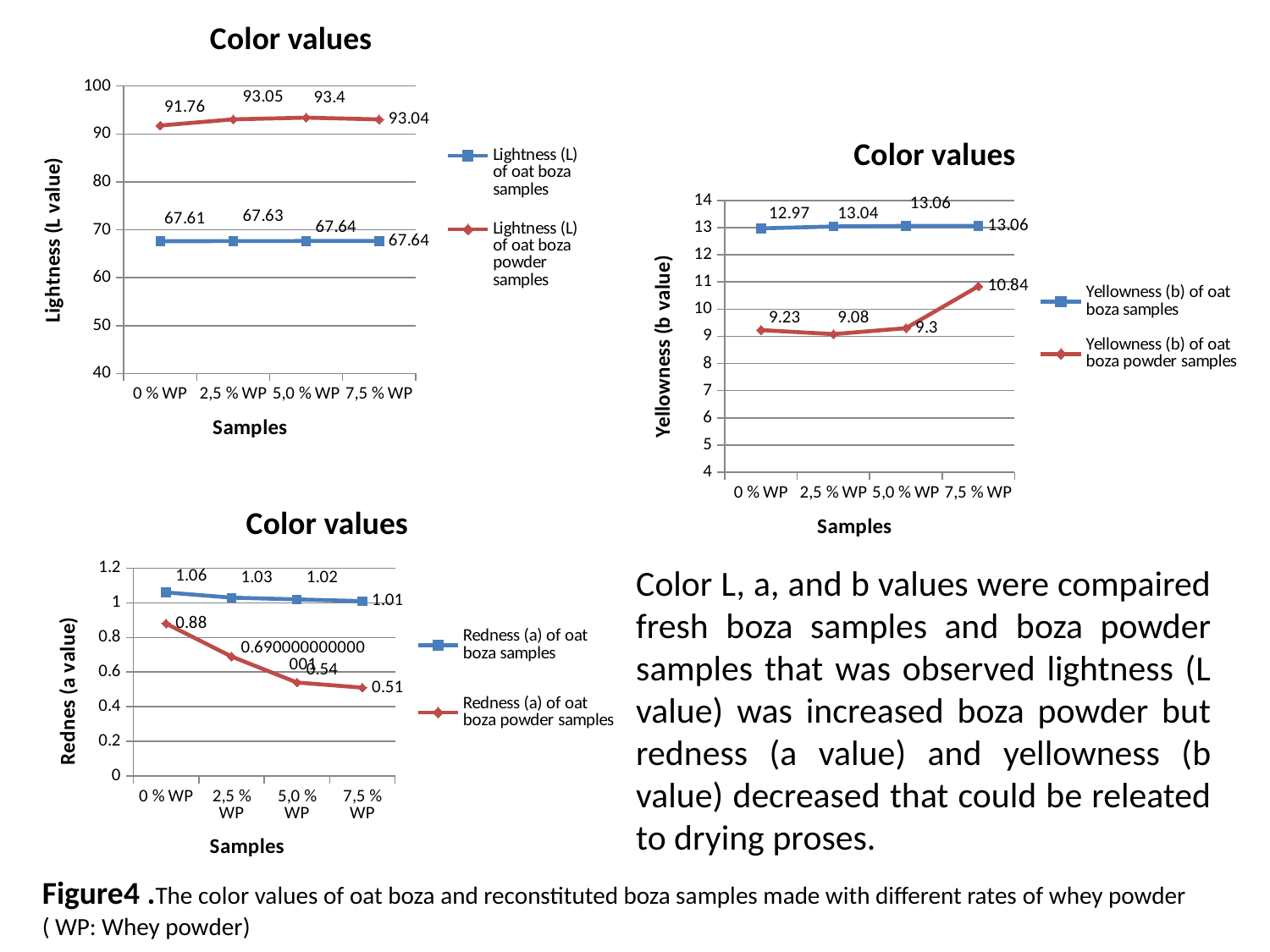
In the bottom-left chart, what is the difference between the redness of the oat boza powder sample at 0 % WP and at 7,5 % WP? 0.37 In the top-left chart, what kind of chart is shown? line chart In the top-left chart, what is the difference between the lightness of the oat boza powder sample and the oat boza sample at 7,5 % WP? 25.4 How many sample categories are shown on the x axis of the bottom-left chart? 4 In the top-right chart, what is the yellowness (b) of the oat boza powder sample at 7,5 % WP? 10.84 In the top-left chart, at which sample is the lightness of the oat boza powder samples highest? 5,0 % WP How many series does the legend of the top-right chart list? 2 In the top-right chart, at which sample is the yellowness of the oat boza powder samples lowest? 2,5 % WP In the top-right chart, at 0 % WP, which series has the higher yellowness value? Yellowness (b) of oat boza samples In the top-left chart, what is the lightness (L) of the oat boza powder sample at 0 % WP? 91.76 In the bottom-left chart, what is the redness (a) of the oat boza sample at 0 % WP? 1.06 In the bottom-left chart, does the redness of the oat boza powder samples rise or fall from 0 % WP to 7,5 % WP? fall